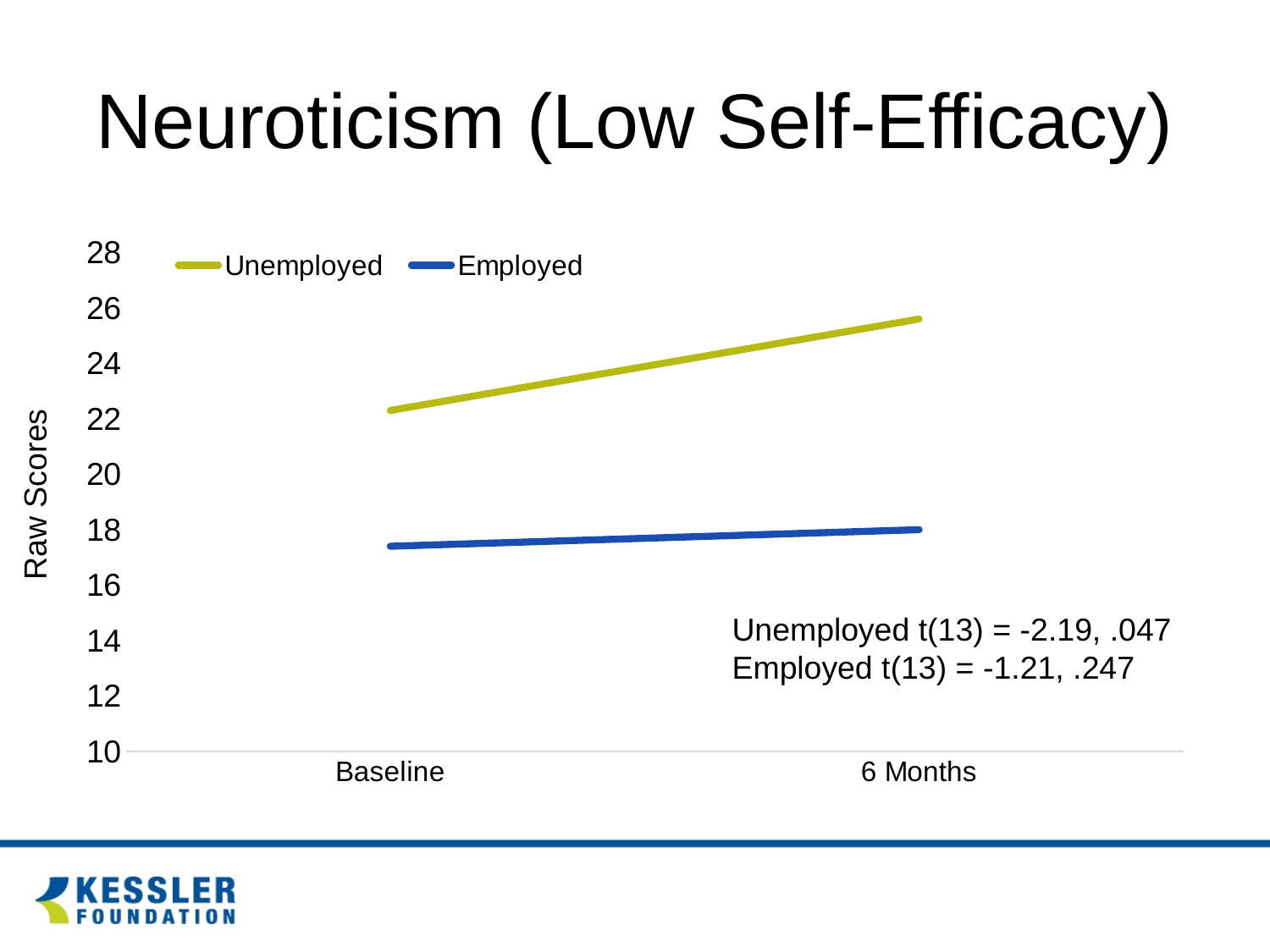
What is the title of the chart's y axis? Raw Scores How many time points are shown on the x axis? 2 What kind of chart is shown on the slide? line chart Which series has the higher value at Baseline, Unemployed or Employed? Unemployed How many series does the legend list? 2 Does the Unemployed line rise or fall from Baseline to 6 Months? rise Is the value for Unemployed at Baseline greater or less than 20? greater What is the title of the slide? Neuroticism (Low Self-Efficacy) Is the value for Employed at 6 Months greater or less than 20? less Is the value for Unemployed at 6 Months greater or less than 24? greater Which series has the higher value at 6 Months, Unemployed or Employed? Unemployed